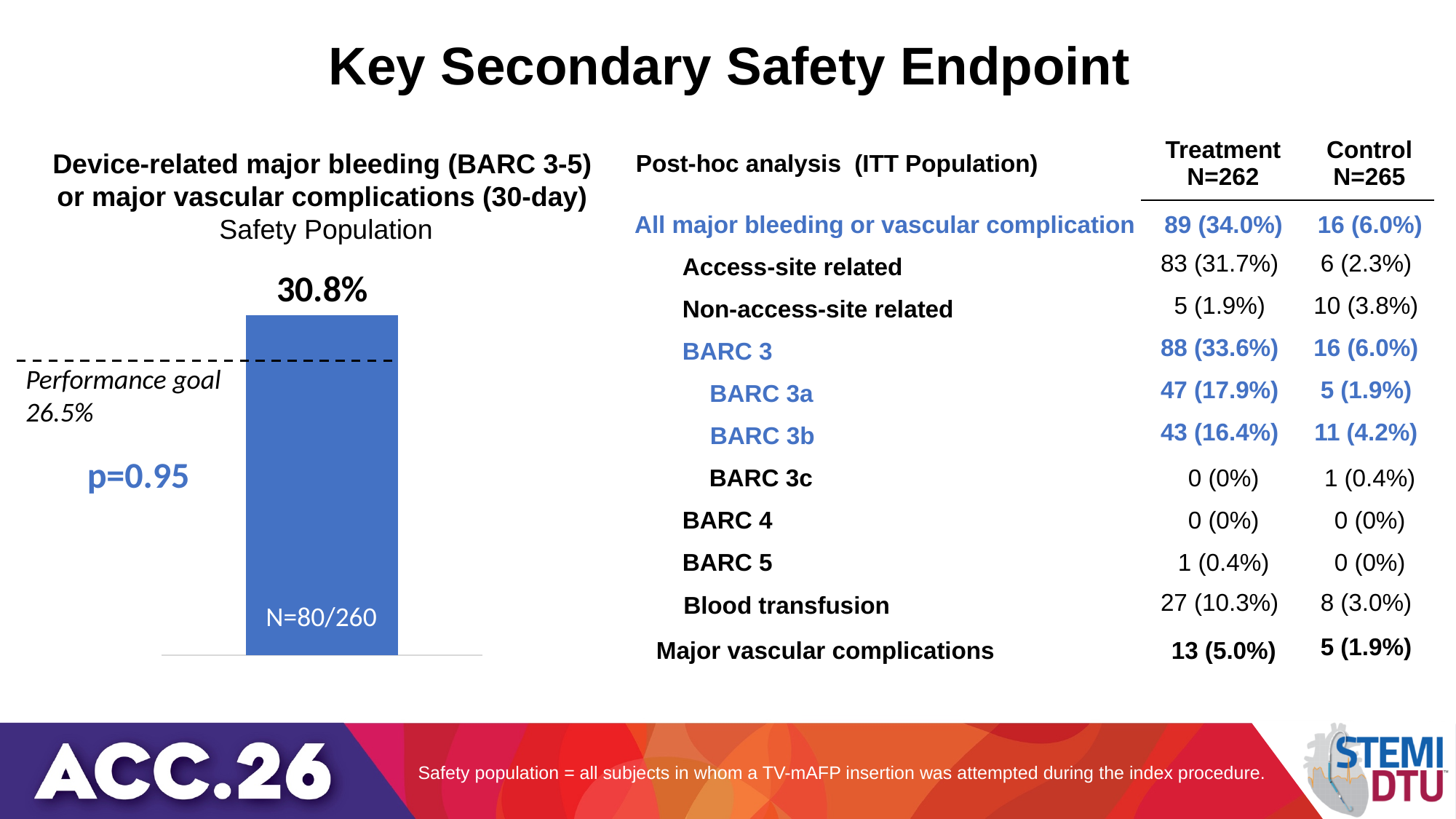
What is the performance goal marked by the dashed line in the chart on the left? 26.5% What type of chart is shown on the left of the slide? bar chart What is the value shown on the bar in the chart on the left? 30.8% In the chart on the left, is the bar value higher or lower than the performance goal? higher In the chart on the left, by how many percentage points does the bar value exceed the performance goal of 26.5%? 4.3 percentage points How many bars does the chart on the left contain? 1 What p-value is shown next to the bar chart on the left? p=0.95 What N is printed inside the bar in the chart on the left? N=80/260